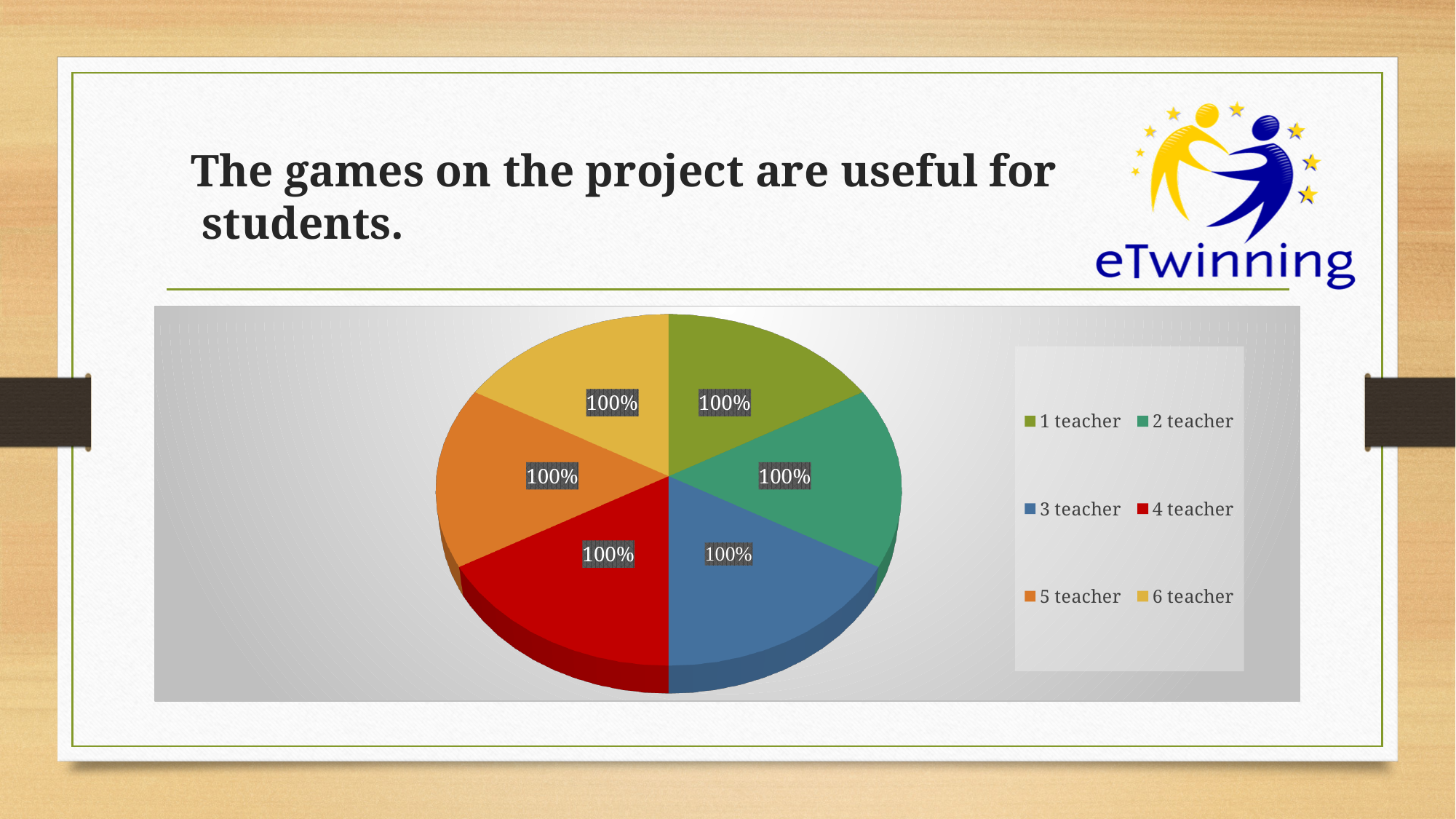
How many entries does the legend list? 6 What value is labelled on the slice for 4 teacher? 100% How many slices does the pie chart have? 6 What value is labelled on the slice for 1 teacher? 100% What kind of chart is shown on the slide? pie chart Which legend entry is shown in red? 4 teacher What value is labelled on the slice for 3 teacher? 100% What is the title of the slide containing the pie chart? The games on the project are useful for students. What value is labelled on the slice for 6 teacher? 100% What is the difference between the labelled values for 2 teacher and 5 teacher? 0%